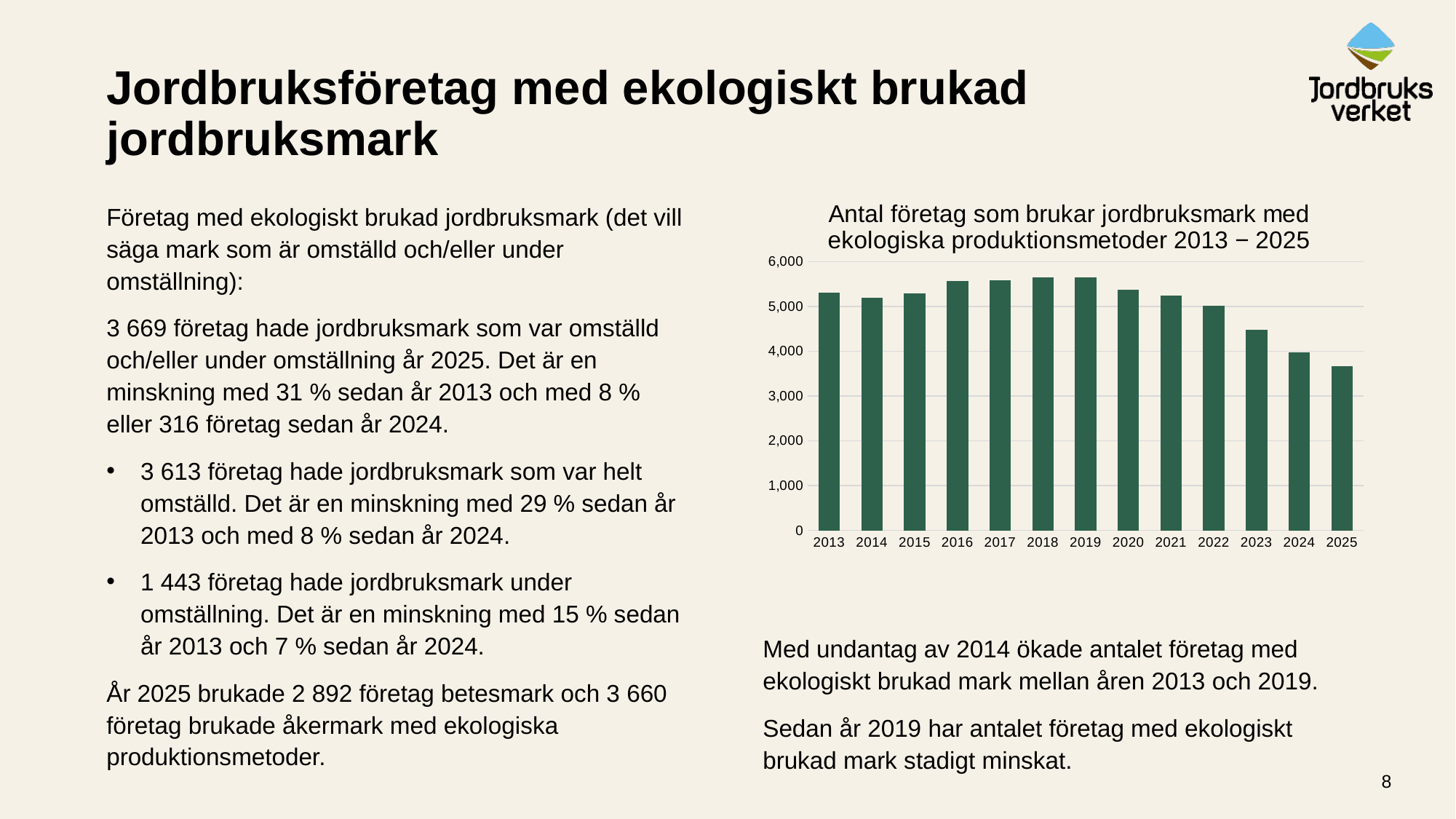
Is the value for 2023 greater or less than 4,000? greater Which year has the lowest number of companies in the chart? 2025 Is the value for 2023 greater or less than 5,000? less Is the value for 2013 greater or less than 5,000? greater Do the values rise or fall from 2019 to 2025? fall Which year has the larger value, 2023 or 2024? 2023 What is the title of the chart? Antal företag som brukar jordbruksmark med ekologiska produktionsmetoder 2013 − 2025 What kind of chart is shown on the slide? bar chart How many years are plotted on the x axis of the chart? 13 Which year has the larger value, 2013 or 2025? 2013